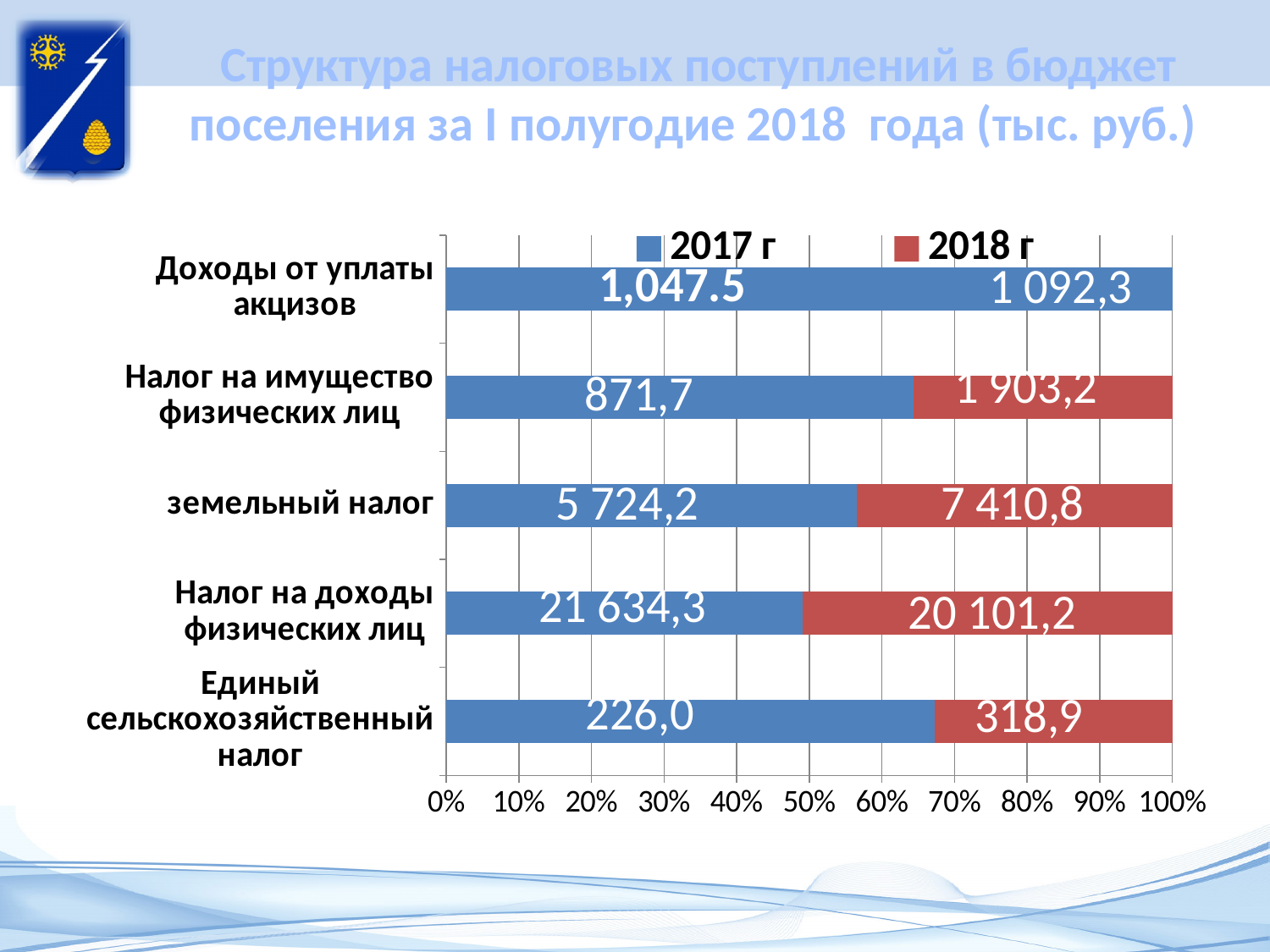
What is the 2018 г value for Налог на имущество физических лиц? 1 903,2 What is the 2017 г value for Налог на доходы физических лиц? 21 634,3 What is the 2018 г value for земельный налог? 7 410,8 Which category has the lowest 2017 г value? Единый сельскохозяйственный налог What is the 2017 г value for земельный налог? 5 724,2 Which category has the highest 2018 г value? Налог на доходы физических лиц What is the 2018 г value for Единый сельскохозяйственный налог? 318,9 What is the difference between the 2018 г and 2017 г values for Единый сельскохозяйственный налог? 92,9 How many categories are shown on the chart? 5 How many series does the legend list? 2